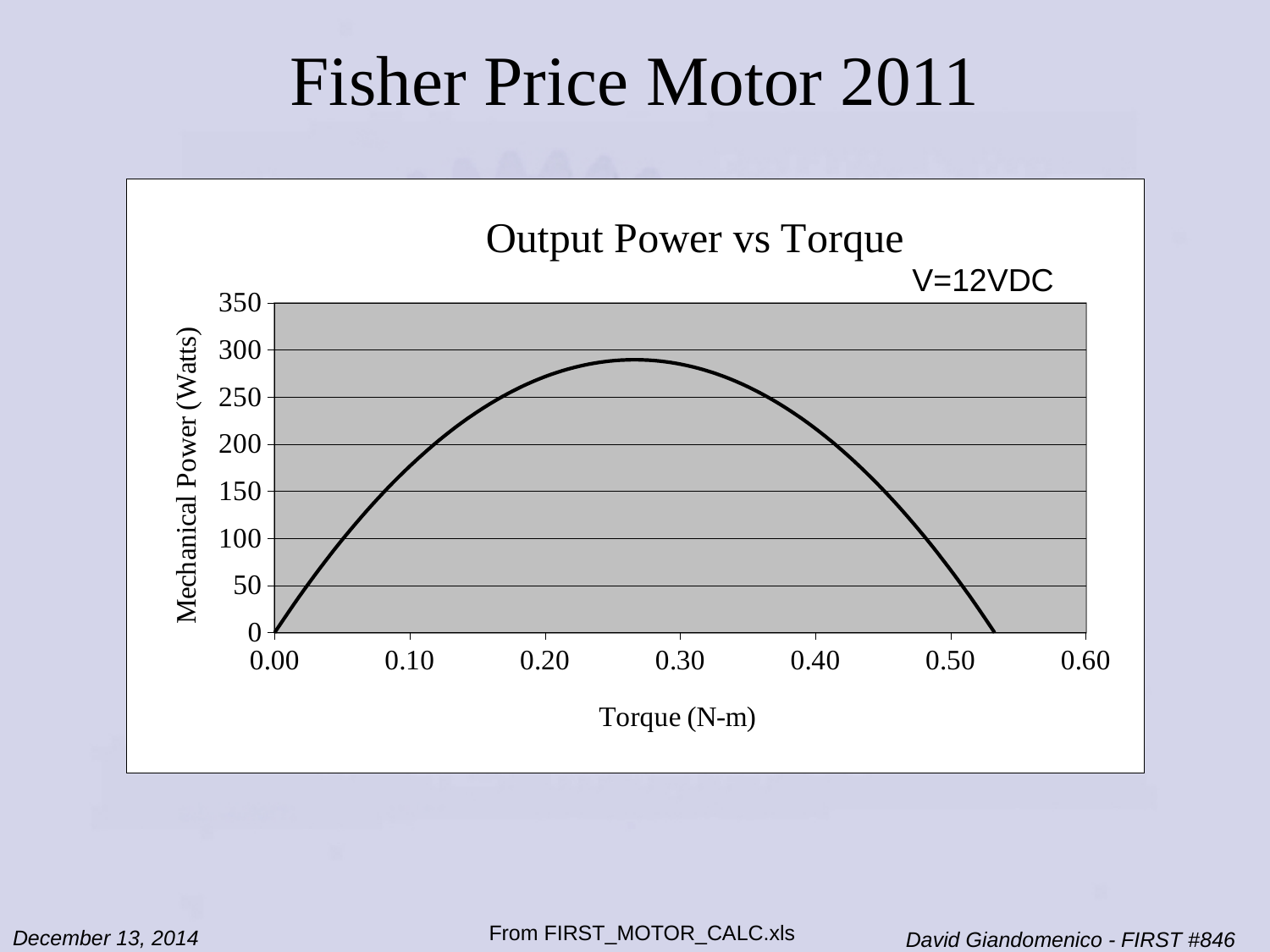
Which is larger, the mechanical power at a torque of 0.30 N-m or at 0.50 N-m? 0.30 N-m Does the mechanical power rise or fall as torque increases from 0.30 to 0.50 N-m? falls Is the mechanical power at a torque of 0.30 N-m greater or less than 250? greater How does the mechanical power change as torque increases from 0.00 to 0.60 N-m? rises then falls What is the mechanical power at a torque of 0.00 N-m? 0 What is the label of the vertical axis of the chart? Mechanical Power (Watts) Is the mechanical power at a torque of 0.50 N-m greater or less than 100? less What is the title of the chart? Output Power vs Torque Is the mechanical power at a torque of 0.40 N-m greater or less than 250? less What kind of chart is shown on the slide? line chart